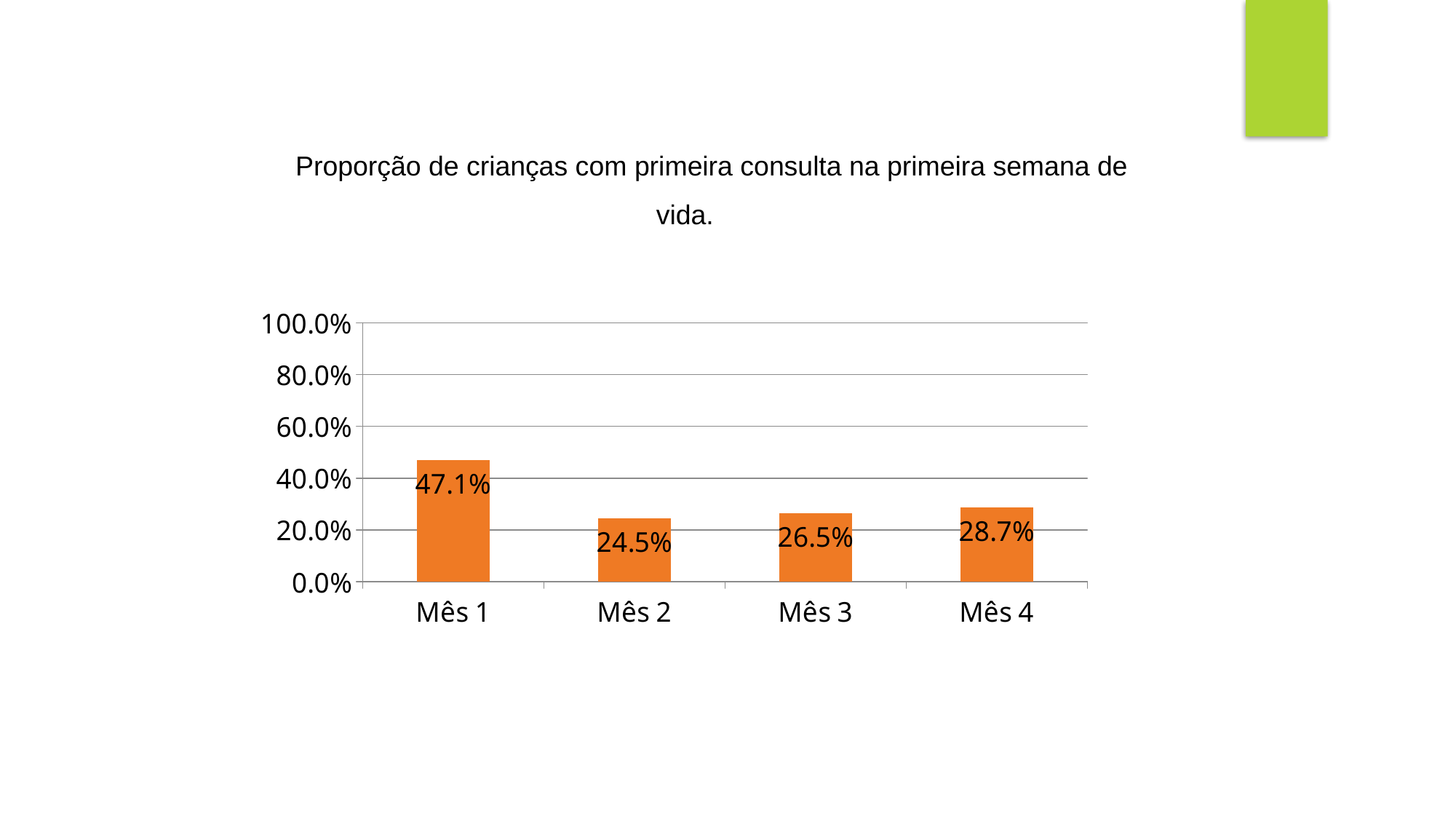
What is the value for Mês 4? 28.7% What is the difference between the values for Mês 1 and Mês 2? 22.6% What is the value for Mês 3? 26.5% What is the value for Mês 1? 47.1% Which month has the highest value? Mês 1 How many months are shown on the x axis? 4 Which month has the lowest value? Mês 2 What kind of chart is shown on the slide? bar chart Which is larger, the value for Mês 3 or the value for Mês 4? Mês 4 Do the values rise or fall from Mês 2 to Mês 4? rise Is the value for Mês 1 greater or less than 40.0%? greater What is the value for Mês 2? 24.5%